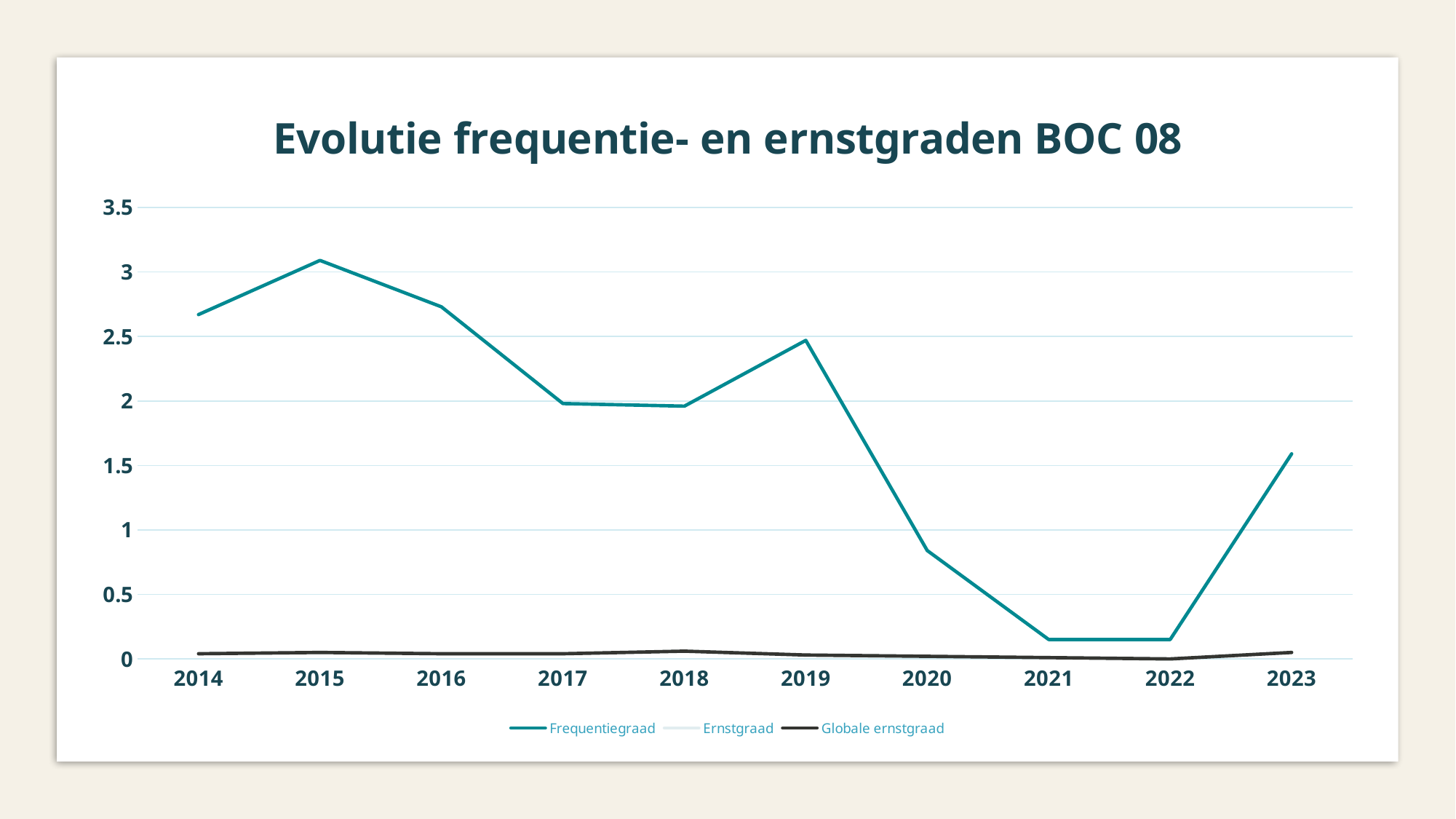
Is the Frequentiegraad value for 2015 greater or less than 3? greater Does the Frequentiegraad line rise or fall between 2019 and 2021? fall How many series does the legend list? 3 Does the Frequentiegraad line rise or fall between 2022 and 2023? rise How many years are plotted along the x axis? 10 Is the Frequentiegraad value for 2021 greater or less than 0.5? less In which year does the Frequentiegraad line reach its highest value? 2015 What is the title of the chart? Evolutie frequentie- en ernstgraden BOC 08 Which year has the larger Frequentiegraad value, 2019 or 2020? 2019 Is the Frequentiegraad value for 2020 greater or less than 1? less What kind of chart is shown on the slide? line chart